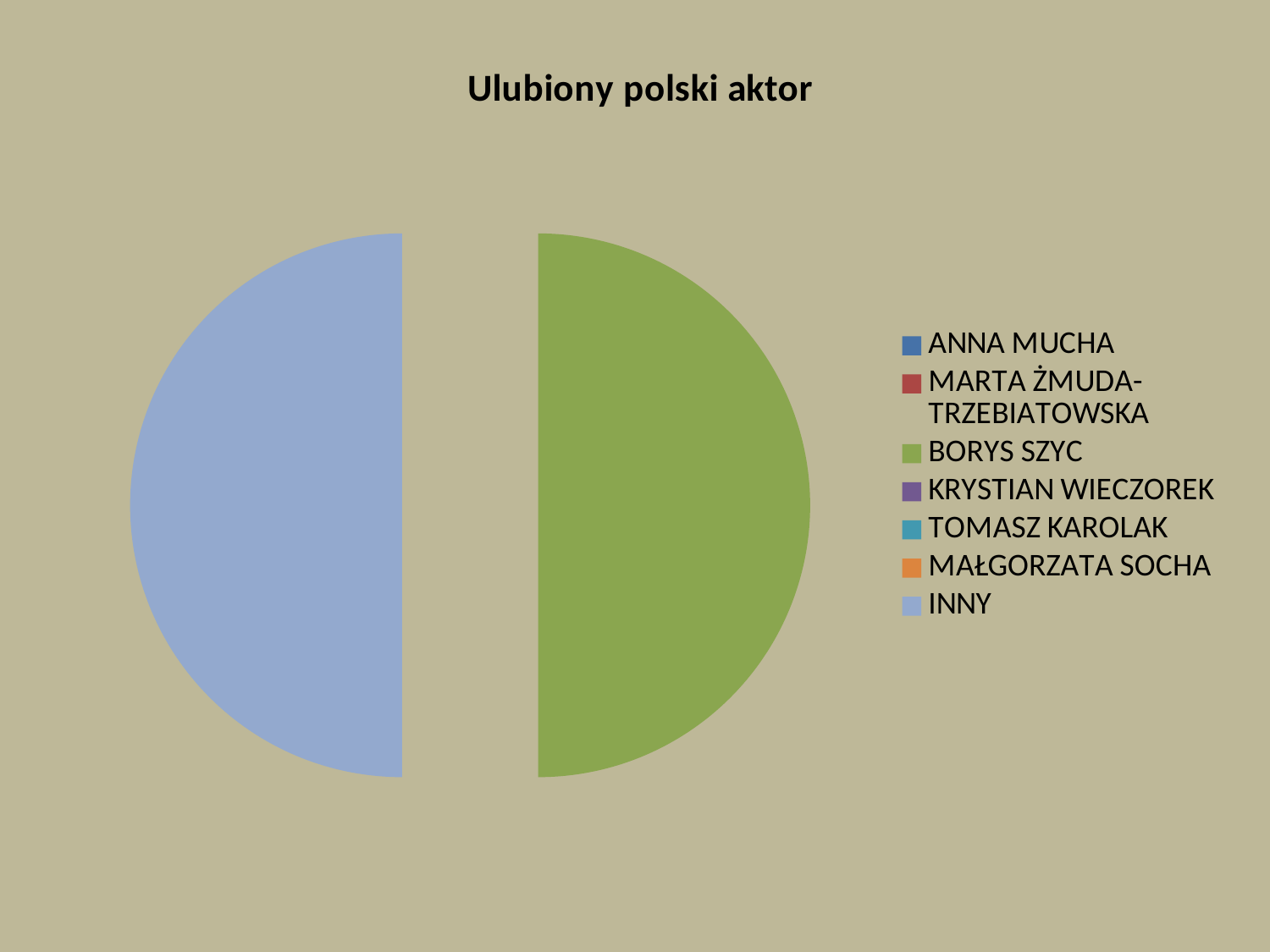
What is the title of the chart? Ulubiony polski aktor How many entries does the chart's legend list? 7 Which legend entry is listed last in the legend? INNY Which two categories have visible slices in the pie chart? BORYS SZYC and INNY How many slices are visible in the pie chart? 2 What kind of chart is shown on the slide? pie chart Which legend entry does the green slice of the pie represent? BORYS SZYC Which legend entry does the light blue slice of the pie represent? INNY Which legend entry is listed first in the legend? ANNA MUCHA